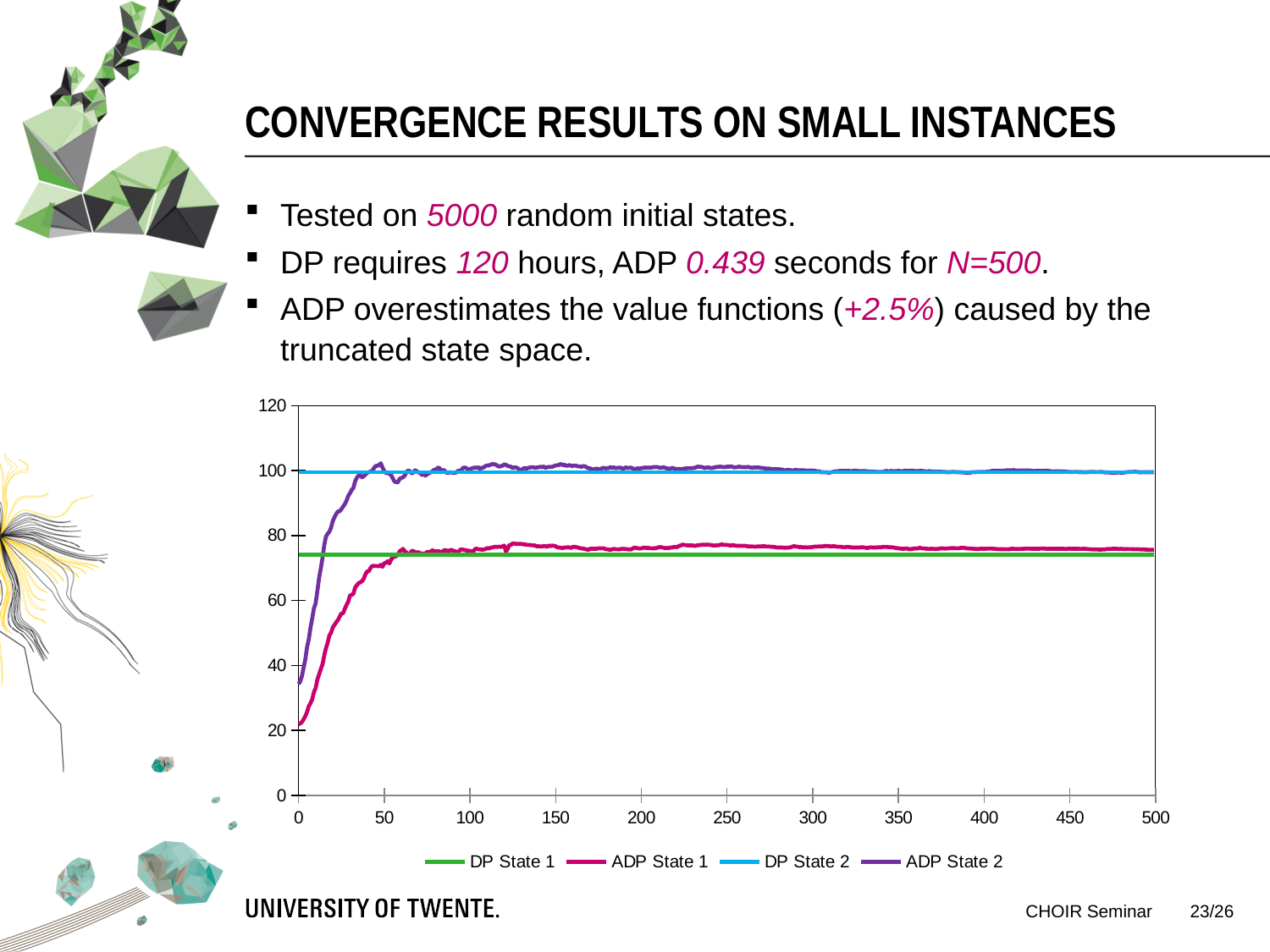
At x = 0, which is larger, ADP State 1 or ADP State 2? ADP State 2 Is the value of the DP State 1 line greater or less than 80? less What is the highest value shown on the y axis of the chart? 120 How does the ADP State 1 line behave as x increases from 0 to 500? rises sharply, then levels off What colour is the line for ADP State 2 in the chart? purple Which line is higher on the chart, DP State 1 or DP State 2? DP State 2 Is the value of the DP State 2 line greater or less than 80? greater What are the four series named in the chart legend? DP State 1, ADP State 1, DP State 2, ADP State 2 Is the value of ADP State 2 at x = 500 greater or less than 80? greater How many series does the chart legend list? 4 What kind of chart is shown on the slide? line chart